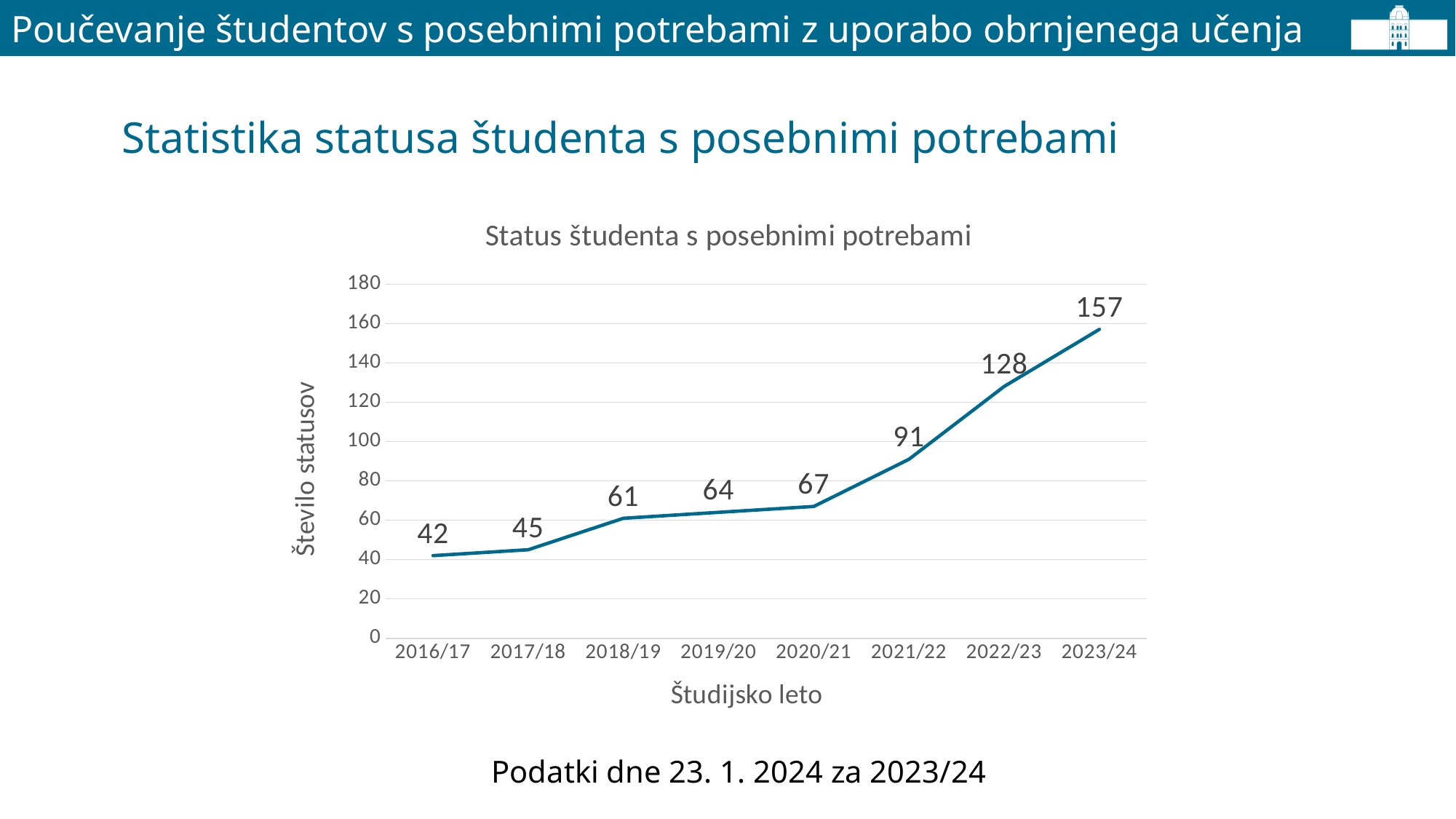
What is the value for 2020/21? 67 What is the value for 2023/24? 157 Which is larger, the value for 2019/20 or the value for 2018/19? 2019/20 What is the difference between the values for 2023/24 and 2022/23? 29 Is the value for 2022/23 greater or less than 120? greater How many academic years are plotted on the x axis? 8 Do the values rise or fall from 2016/17 to 2023/24? rise Which academic year has the lowest value? 2016/17 Which academic year has the highest value? 2023/24 What is the value for 2016/17? 42 What is the difference between the values for 2021/22 and 2020/21? 24 What kind of chart is shown? line chart